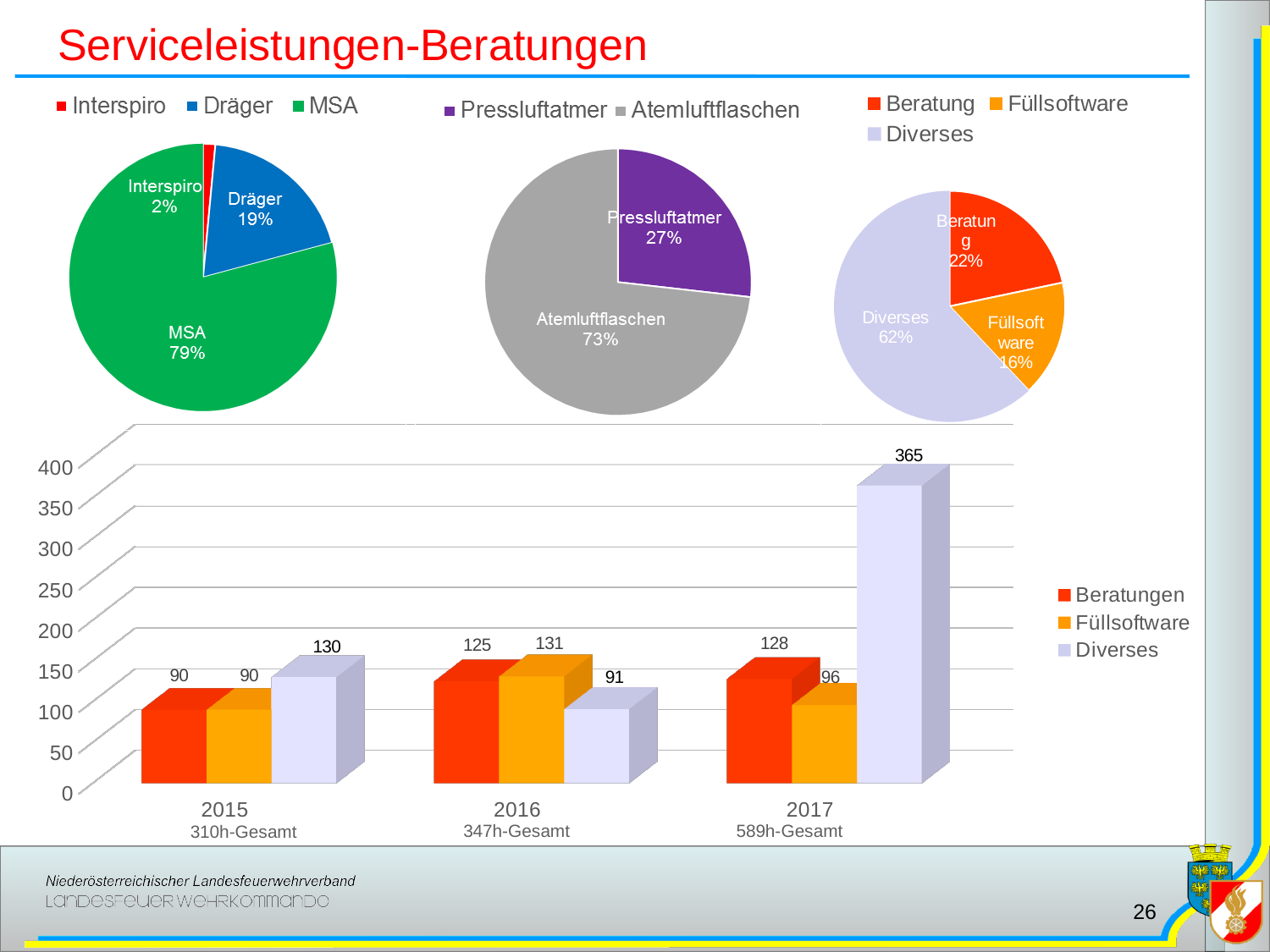
In the bottom bar chart, what is the difference between Diverses in 2017 and Diverses in 2016? 274 In the bottom bar chart, how many series does the legend list? 3 What kind of chart is shown at the bottom of the slide? Bar chart In the top-left pie chart, which category has the smallest share? Interspiro In the top-left pie chart, what share does MSA have? 79% In the top-right pie chart, which category has the largest share? Diverses In the bottom bar chart, how many years are shown on the x axis? 3 In the bottom bar chart, what is the value for Diverses in 2017? 365 In the bottom bar chart, which is larger: Füllsoftware in 2016 or Füllsoftware in 2017? Füllsoftware in 2016 In the top-middle pie chart, what share does Atemluftflaschen have? 73% In the top-right pie chart, what share does Füllsoftware have? 16% In the bottom bar chart, what is the value for Beratungen in 2016? 125